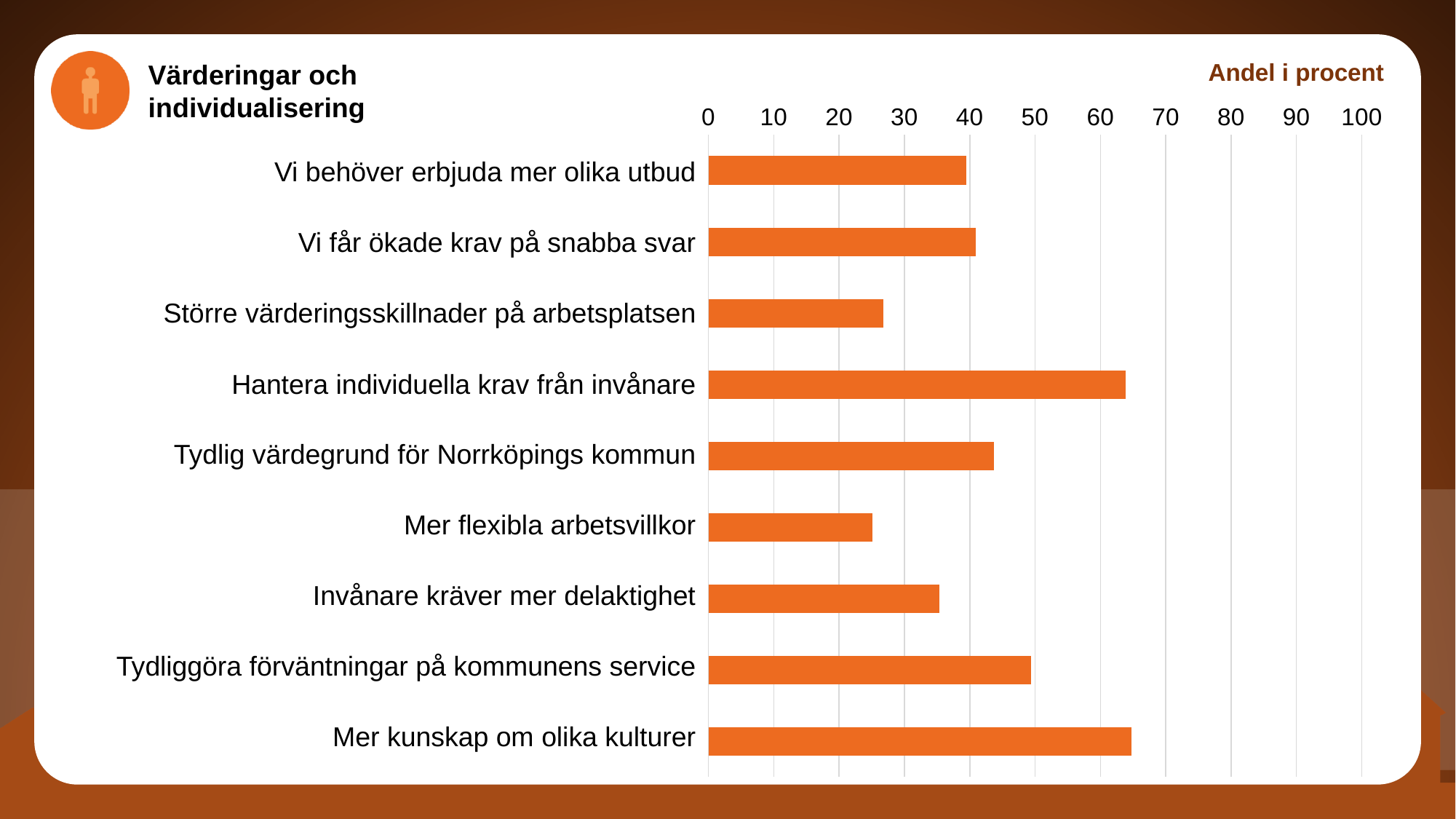
What label is shown above the horizontal axis of the chart? Andel i procent Is the value for "Mer flexibla arbetsvillkor" greater or less than 30? less How many categories are plotted in the chart? 9 Is the value for "Större värderingsskillnader på arbetsplatsen" greater or less than 30? less What is the title of the chart? Värderingar och individualisering What kind of chart is shown on the slide? bar chart Is the value for "Invånare kräver mer delaktighet" greater or less than 40? less Which is larger: the value for "Invånare kräver mer delaktighet" or for "Tydliggöra förväntningar på kommunens service"? Tydliggöra förväntningar på kommunens service Which is larger: the value for "Hantera individuella krav från invånare" or for "Mer flexibla arbetsvillkor"? Hantera individuella krav från invånare